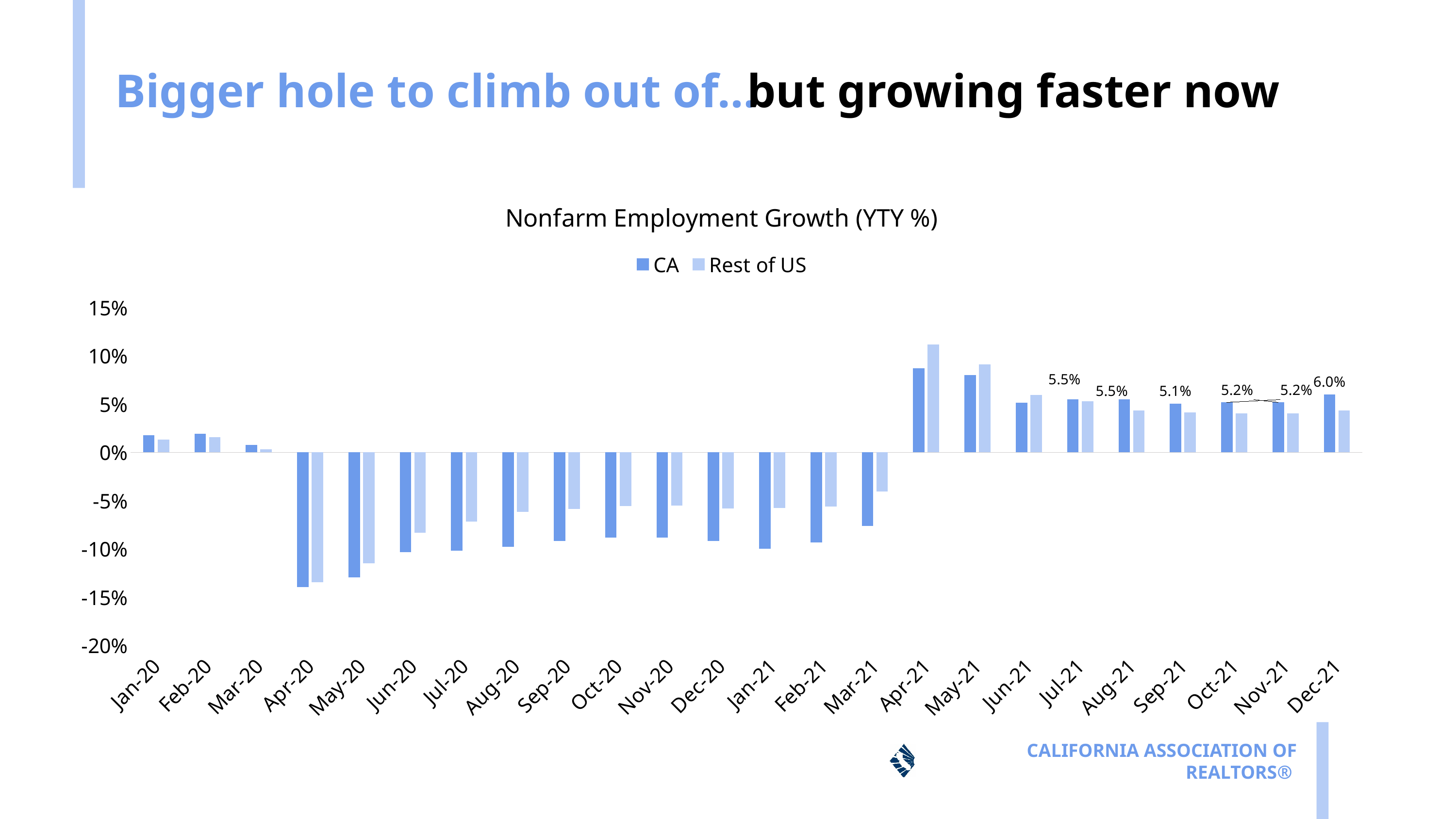
What kind of chart is shown on the slide? Bar chart How many months are shown on the x axis? 24 What is the CA value for Jul-21? 5.5% What is the CA value for Sep-21? 5.1% Which month has the lowest CA value? Apr-20 What is the CA value for Dec-21? 6.0% What is the difference between the CA values for Dec-21 and Sep-21? 0.9 percentage points Which month has the highest Rest of US value? Apr-21 Is the Rest of US value for Apr-21 greater or less than 10%? greater In Apr-21, which is larger, the CA value or the Rest of US value? Rest of US How many series does the legend list? 2 Is the CA value for Apr-20 greater or less than -10%? less